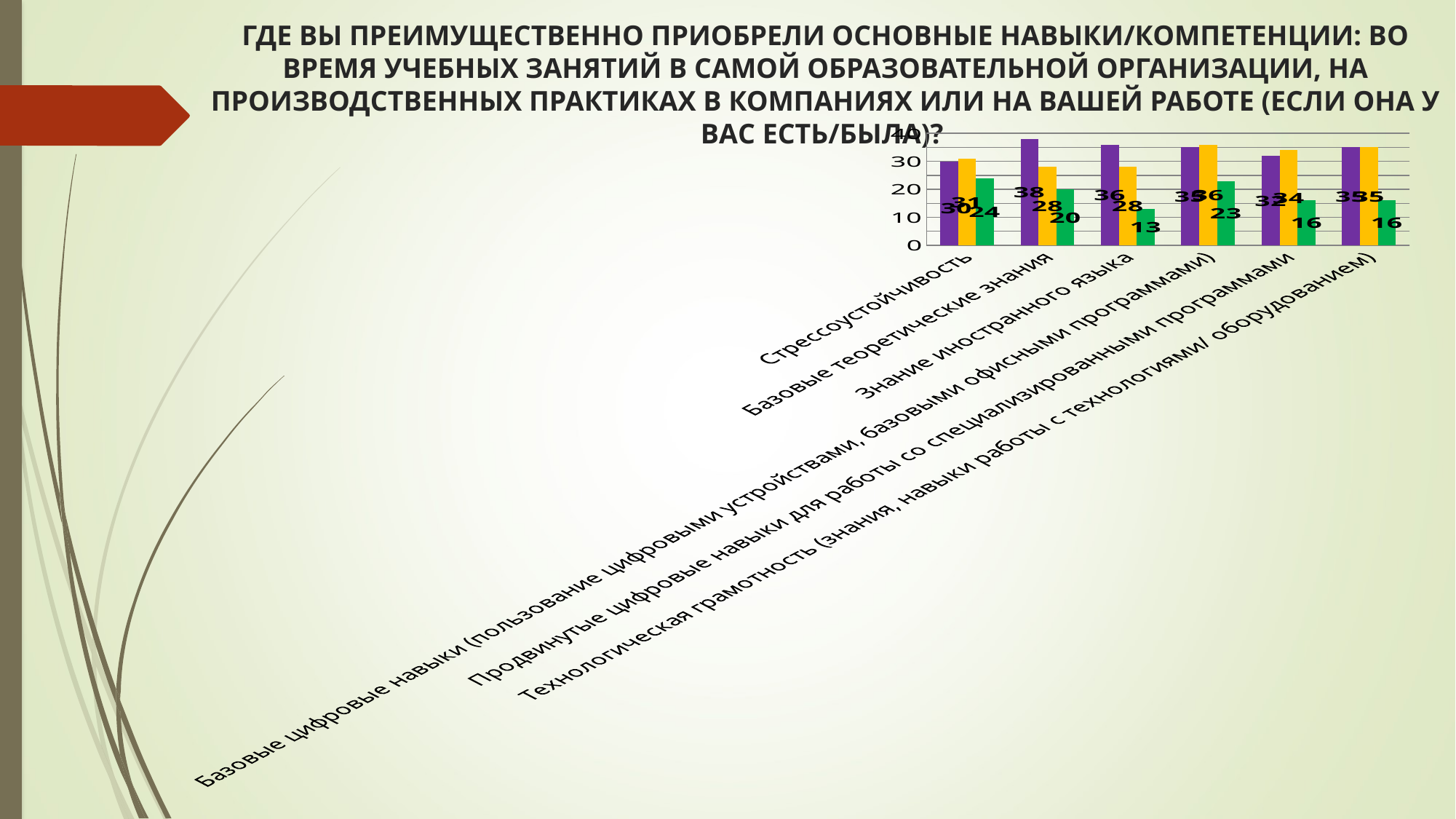
What is the difference between the purple bar and the green bar for "Базовые теоретические знания"? 18 Is the green bar for "Продвинутые цифровые навыки для работы со специализированными программами" greater or less than 20? less Which category has the highest purple bar? Базовые теоретические знания What is the value of the purple bar for "Базовые теоретические знания"? 38 What is the value of the green bar for "Базовые теоретические знания"? 20 How many bars are plotted for each category in the chart? 3 What kind of chart is shown on the slide? bar chart How many categories are shown along the x axis of the chart? 6 What is the value of the green bar for "Знание иностранного языка"? 13 What is the value of the yellow bar for "Стрессоустойчивость"? 31 Which category has the lowest green bar? Знание иностранного языка Which is larger: the green bar for "Стрессоустойчивость" or the green bar for "Базовые теоретические знания"? Стрессоустойчивость